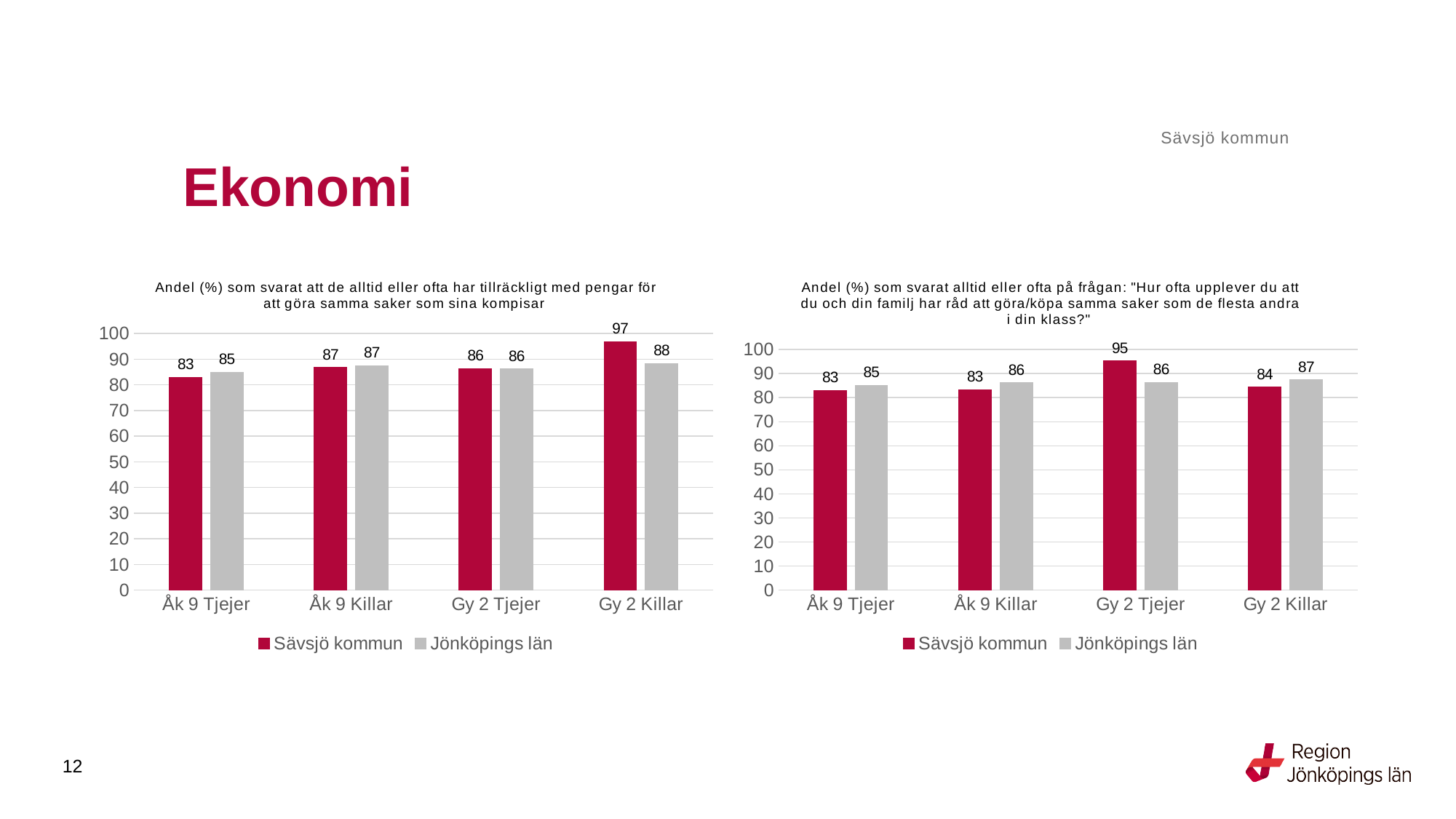
What kind of chart is the left chart (tillräckligt med pengar)? Bar chart In the right chart (råd att göra/köpa samma saker), what is the value for Jönköpings län for Gy 2 Killar? 87 In the left chart (tillräckligt med pengar), what is the difference between Sävsjö kommun and Jönköpings län for Gy 2 Killar? 9 In the right chart (råd att göra/köpa samma saker), what is the value for Sävsjö kommun for Gy 2 Tjejer? 95 In the left chart (tillräckligt med pengar), what is the value for Sävsjö kommun for Gy 2 Killar? 97 In the left chart (tillräckligt med pengar), which category has the highest value for Sävsjö kommun? Gy 2 Killar In the left chart (tillräckligt med pengar), which category has the lowest value for Sävsjö kommun? Åk 9 Tjejer How many categories are shown on the x axis of the right chart (råd att göra/köpa samma saker)? 4 In the left chart (tillräckligt med pengar), what is the value for Jönköpings län for Åk 9 Tjejer? 85 How many series does the legend of the left chart (tillräckligt med pengar) list? 2 In the right chart (råd att göra/köpa samma saker), which is larger for Gy 2 Tjejer: Sävsjö kommun or Jönköpings län? Sävsjö kommun In the right chart (råd att göra/köpa samma saker), what is the difference between Jönköpings län and Sävsjö kommun for Åk 9 Killar? 3